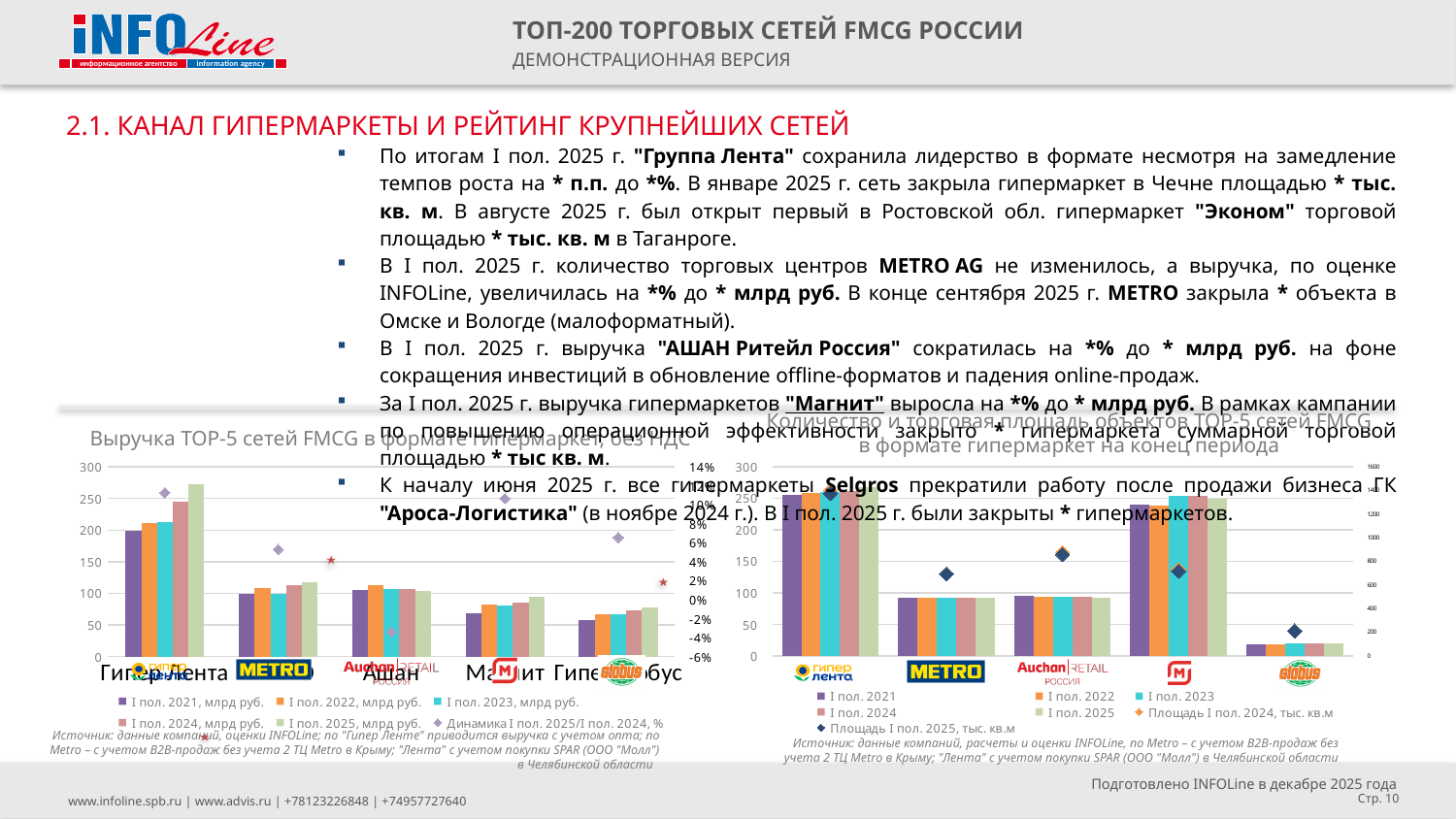
How many retail chains (categories) are shown on the left chart, "Выручка ТОР-5 сетей FMCG в формате гипермаркет, без НДС"? 5 On the right chart ("Количество и торговая площадь объектов ТОР-5 сетей FMCG в формате гипермаркет"), how many entries does the legend list? 7 On the right chart ("Количество и торговая площадь объектов ТОР-5 сетей FMCG в формате гипермаркет"), is the number of Гипер Лента hypermarkets in I пол. 2025 greater or less than 200? greater On the left chart (revenue of TOP-5 hypermarket chains), is the I пол. 2025 revenue for Гипер Лента greater or less than 250? greater On the left chart (revenue of TOP-5 hypermarket chains), which chain has the lowest revenue in I пол. 2025? Гиперглобус On the right chart ("Количество и торговая площадь объектов ТОР-5 сетей FMCG в формате гипермаркет"), which chain has the highest number of hypermarkets in I пол. 2025? Гипер Лента On the right chart ("Количество и торговая площадь объектов ТОР-5 сетей FMCG в формате гипермаркет"), is the number of METRO hypermarkets in I пол. 2025 greater or less than 100? less On the left chart (revenue of TOP-5 hypermarket chains), do the revenue bars for Гипер Лента rise or fall from I пол. 2021 to I пол. 2025? rise What kind of chart is the left chart, "Выручка ТОР-5 сетей FMCG в формате гипермаркет, без НДС"? Combination bar and line chart (bars with a marker series for growth dynamics on a secondary axis) On the left chart (revenue of TOP-5 hypermarket chains), which is larger in I пол. 2025: the revenue of METRO or of Магнит Гипер? METRO On the left chart (revenue of TOP-5 hypermarket chains), which chain has the highest revenue in I пол. 2025? Гипер Лента